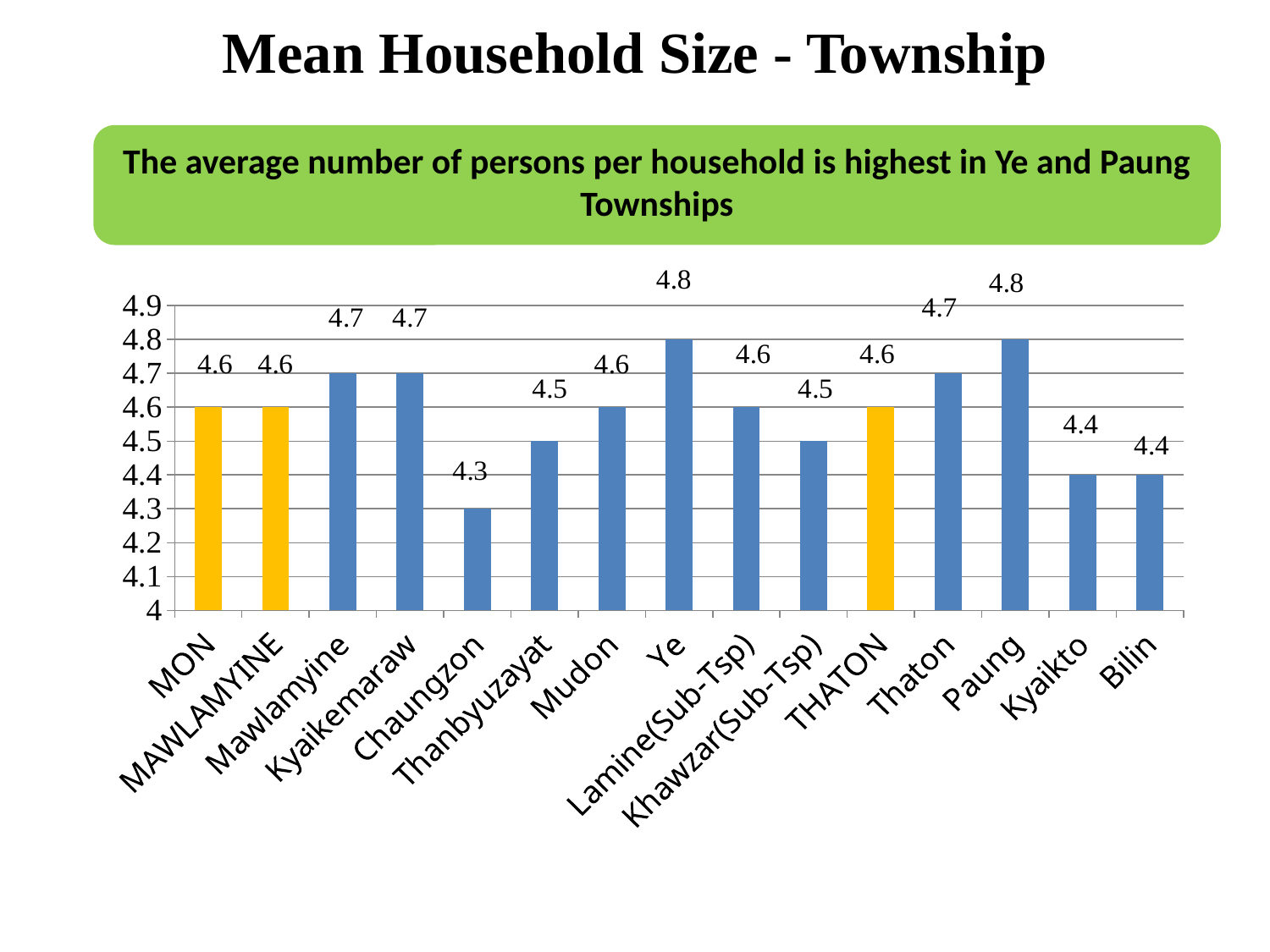
What type of chart is shown on the slide? Bar chart What is the mean household size for Chaungzon? 4.3 Which has a larger mean household size, Kyaikemaraw or Thanbyuzayat? Kyaikemaraw What is the difference between the mean household size of Mawlamyine and Kyaikto? 0.3 What is the mean household size for Thaton? 4.7 Which category has the lowest mean household size? Chaungzon How many categories are shown on the x axis? 15 What is the difference between the mean household size of Ye and Chaungzon? 0.5 Which two townships share the highest mean household size of 4.8? Ye and Paung Which bars are coloured yellow instead of blue? MON, MAWLAMYINE and THATON What is the mean household size for Khawzar(Sub-Tsp)? 4.5 Which has a larger mean household size, Mudon or Bilin? Mudon